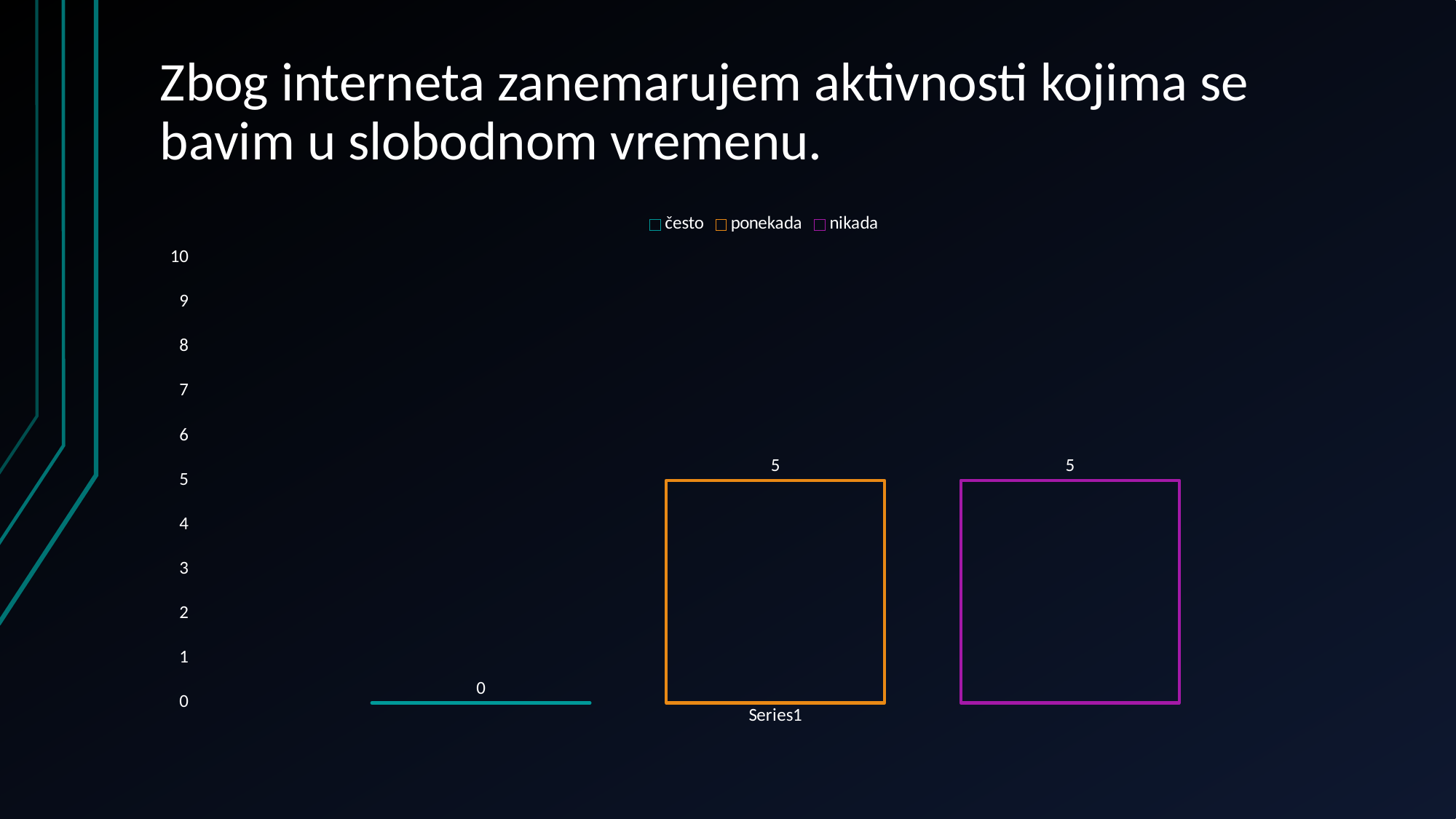
What is the value for "ponekada"? 5 How many series does the legend list? 3 What kind of chart is shown on the slide? bar chart What is the total of the values for često, ponekada and nikada? 10 What is the highest value shown on the vertical axis? 10 What is the value for "nikada"? 5 What is the value for "često"? 0 What is the difference between the values for "ponekada" and "često"? 5 Which series has the lowest value? često What is the category label shown on the horizontal axis? Series1 Which is larger, the value for "nikada" or the value for "često"? nikada